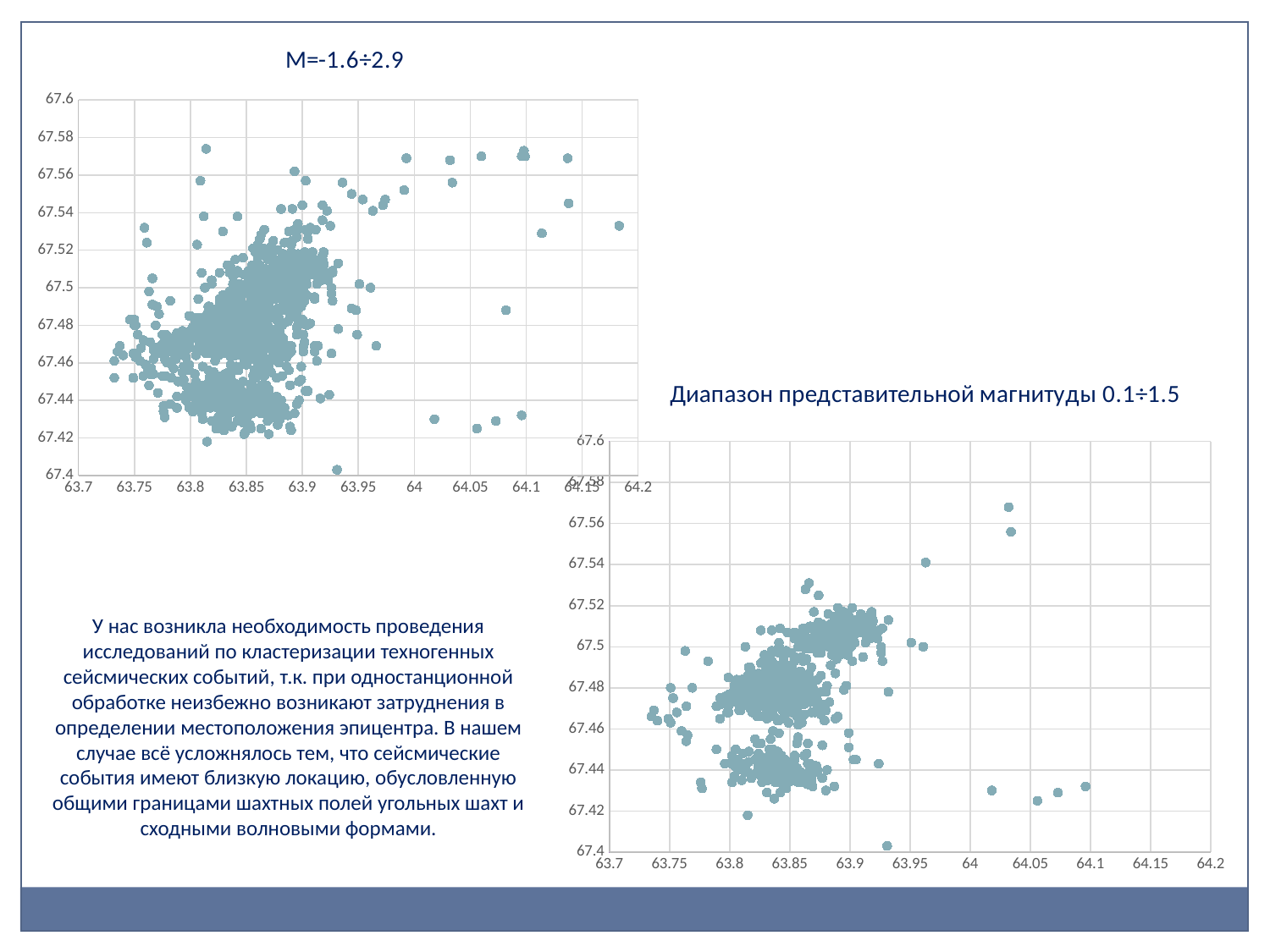
In the bottom-right chart "Диапазон представительной магнитуды 0.1÷1.5", is the y value of the highest point greater or less than 67.58? less What is the title of the top-left chart? M=-1.6÷2.9 What kind of chart is the top-left chart titled "M=-1.6÷2.9"? scatter chart In the bottom-right chart "Диапазон представительной магнитуды 0.1÷1.5", is the x value of the rightmost point greater or less than 64.05? greater In the bottom-right chart "Диапазон представительной магнитуды 0.1÷1.5", is the y value of the lowest point greater or less than 67.42? less What kind of chart is the bottom-right chart titled "Диапазон представительной магнитуды 0.1÷1.5"? scatter chart What is the title of the bottom-right chart? Диапазон представительной магнитуды 0.1÷1.5 Which chart contains more plotted points, the top-left chart "M=-1.6÷2.9" or the bottom-right chart "Диапазон представительной магнитуды 0.1÷1.5"? the top-left chart "M=-1.6÷2.9"